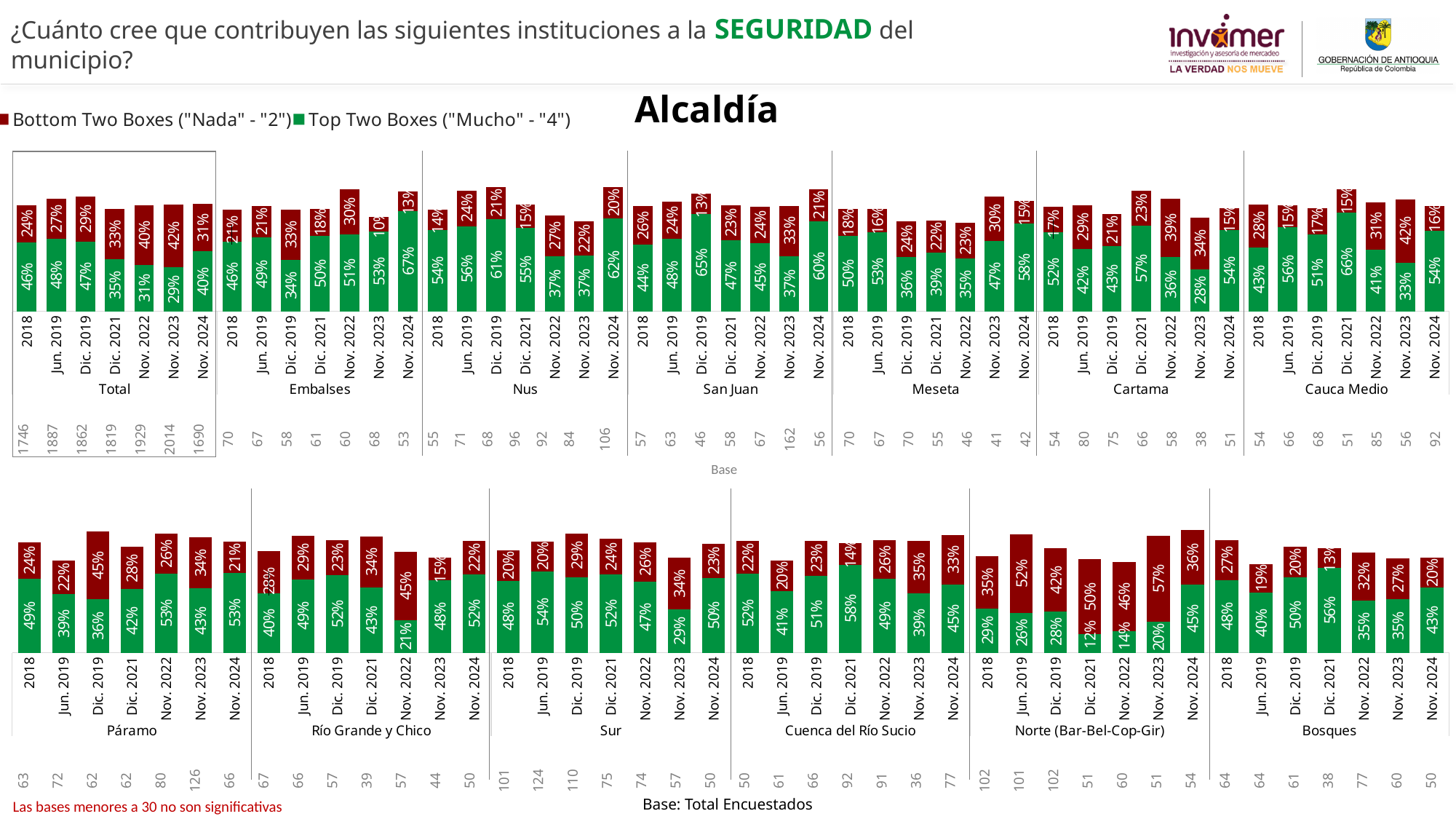
How many series does the legend list? 2 In the top chart, what is the Top Two Boxes value for Total in Nov. 2024? 40% In the top chart, what is the Bottom Two Boxes value for Cauca Medio in Nov. 2023? 42% In the bottom chart, which period has the lowest Top Two Boxes value for Río Grande y Chico? Nov. 2022 In the bottom chart, which is larger for Sur in Nov. 2023: the Top Two Boxes value or the Bottom Two Boxes value? Bottom Two Boxes What kind of chart is shown on the slide? Stacked bar chart In the top chart, what is the total of the stacked bar for San Juan in Dic. 2019? 78% In the bottom chart, what is the Top Two Boxes value for Norte (Bar-Bel-Cop-Gir) in Dic. 2021? 12% In the top chart, what is the difference between the Top Two Boxes values for Total in 2018 and Nov. 2023? 17% What is the title of the chart on the slide? Alcaldía In the bottom chart, how many periods are shown for Bosques? 7 In the top chart, which period has the highest Top Two Boxes value for Embalses? Nov. 2024